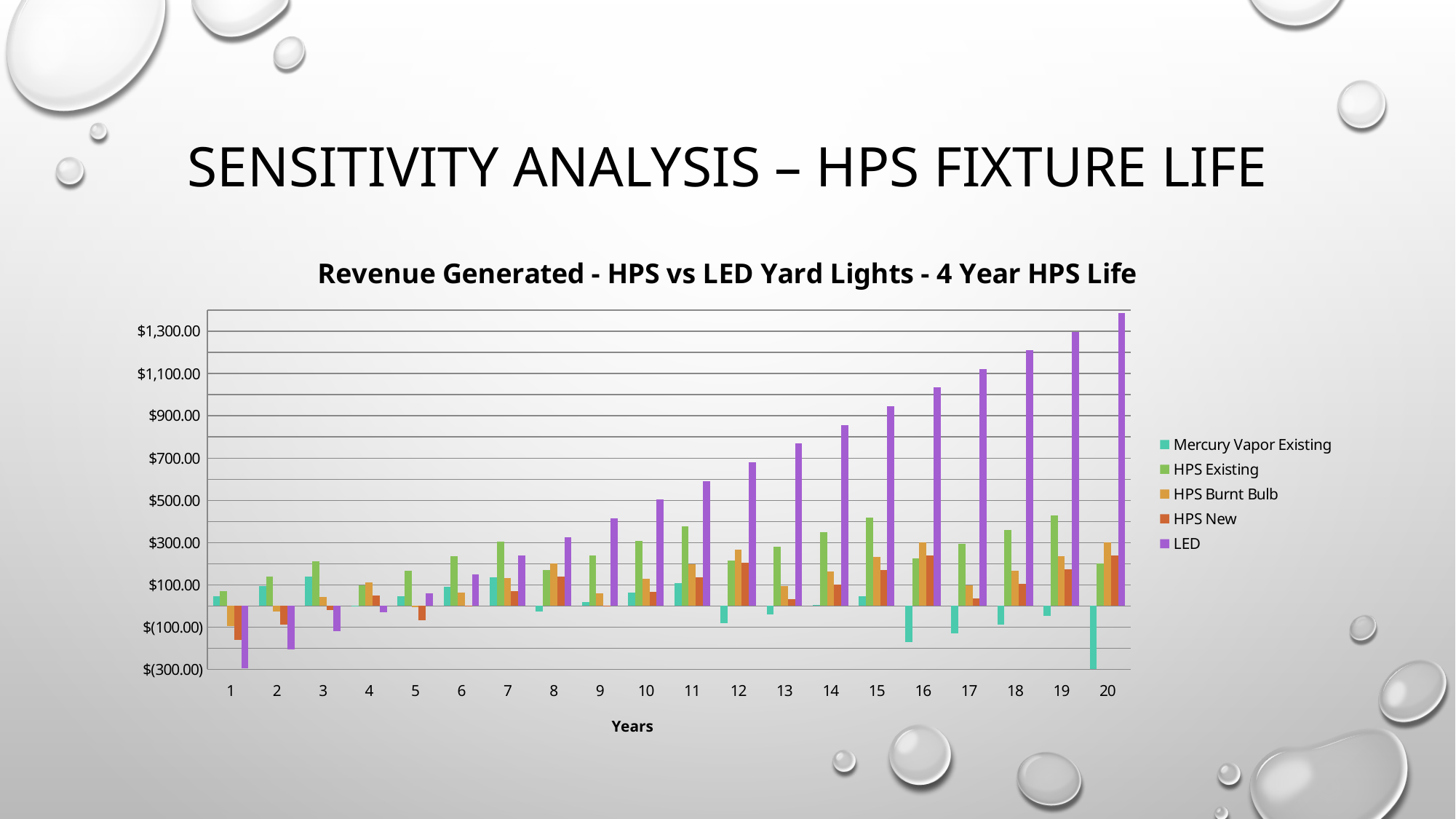
What is the label of the x axis? Years Which series has the highest value in year 20? LED Is the Mercury Vapor Existing value for year 20 greater or less than $(100.00)? less In which year is the LED value lowest? 1 How many series does the legend list? 5 How many years are shown along the x axis? 20 Do the LED values rise or fall from year 1 to year 20? rise What is the title of the chart? Revenue Generated - HPS vs LED Yard Lights - 4 Year HPS Life In which year is the LED value highest? 20 Is the LED value for year 20 greater or less than $1,300.00? greater Is the LED value for year 15 greater or less than $900.00? greater What kind of chart is shown on the slide? bar chart